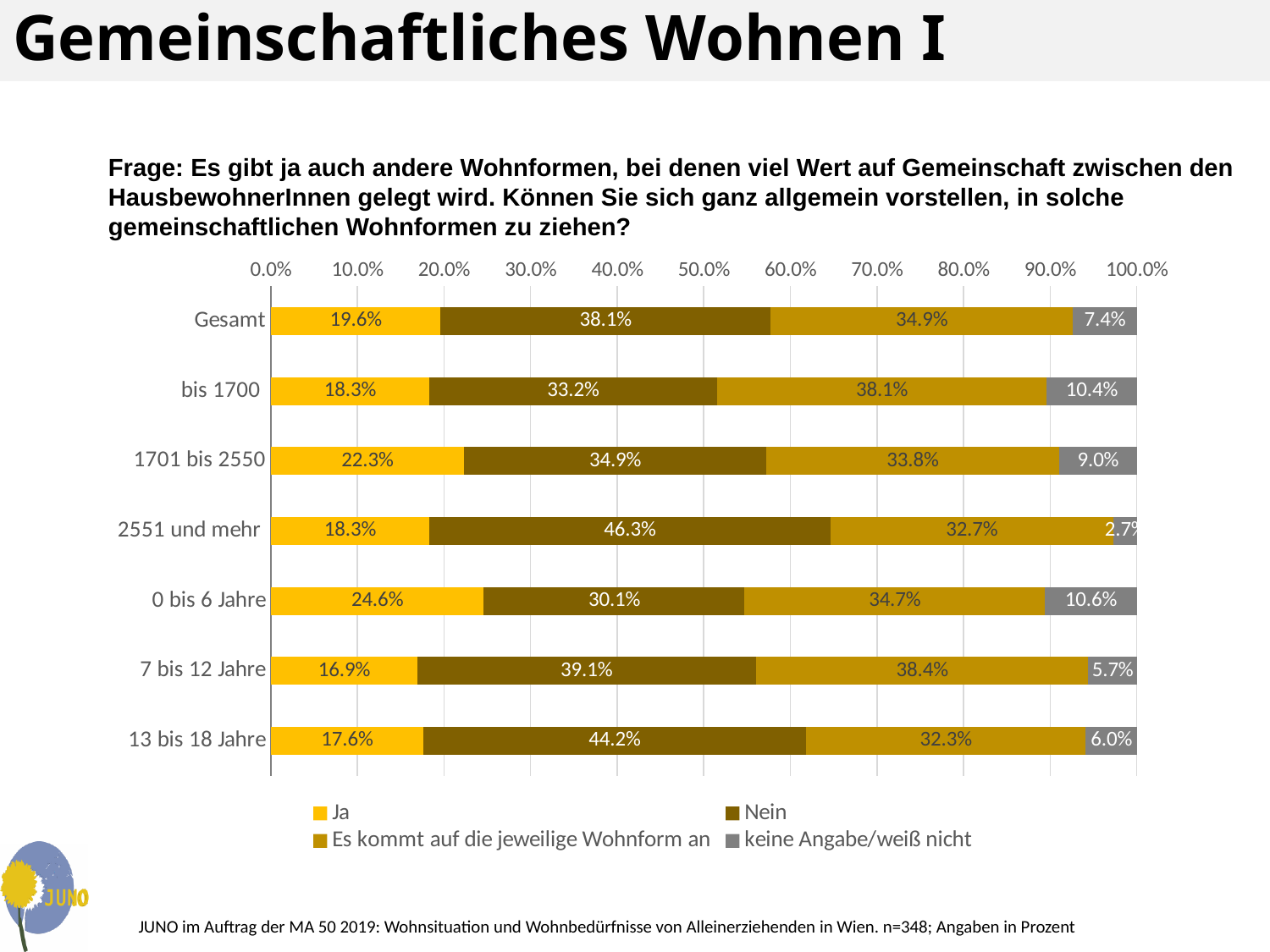
What is the value of "Es kommt auf die jeweilige Wohnform an" for the category "7 bis 12 Jahre"? 38.4% What is the difference between the "Nein" values for "13 bis 18 Jahre" and "Gesamt"? 6.1% Which is larger: the "Ja" value for "1701 bis 2550" or the "Ja" value for "bis 1700"? 1701 bis 2550 How many series does the legend list? 4 Which category has the lowest value for "Nein"? 0 bis 6 Jahre How many categories are plotted on the chart? 7 What is the value of "keine Angabe/weiß nicht" for the category "0 bis 6 Jahre"? 10.6% Which category has the highest value for "Ja"? 0 bis 6 Jahre What is the value of "Ja" for the category "Gesamt"? 19.6% What is the value of "Nein" for the category "2551 und mehr"? 46.3% What kind of chart is shown on the slide? Stacked bar chart Which legend entry is shown in grey? keine Angabe/weiß nicht